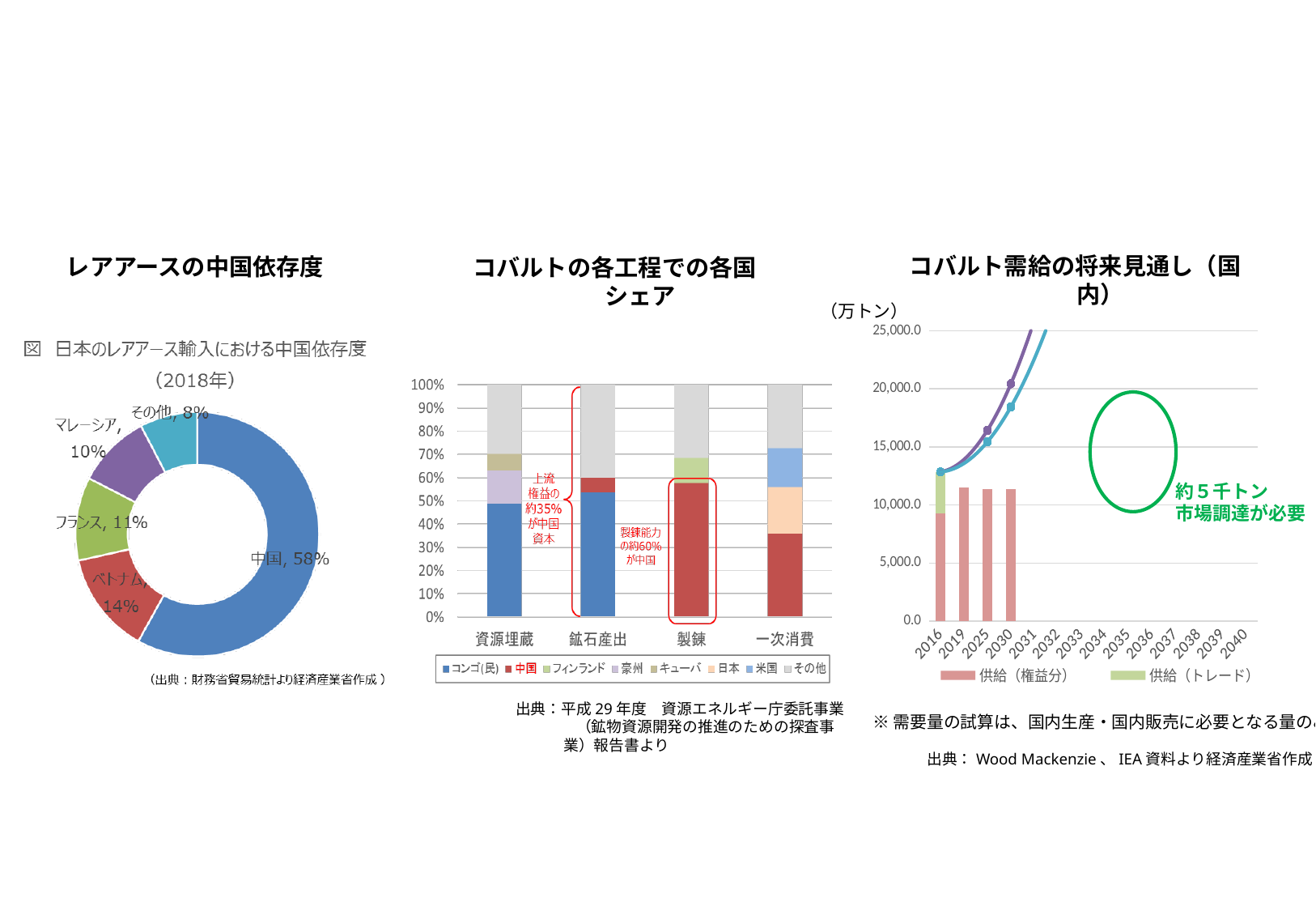
In the donut chart titled レアアースの中国依存度, what share is shown for ベトナム? 14% What kind of chart is the one titled コバルトの各工程での各国シェア? Stacked bar chart How many slices does the donut chart titled レアアースの中国依存度 have? 5 In the donut chart titled レアアースの中国依存度, which has the larger share, フランス or マレーシア? フランス In the donut chart titled レアアースの中国依存度, which slice is the smallest? その他 How many series does the legend of the chart titled コバルト需給の将来見通し（国内） list? 2 In the donut chart titled レアアースの中国依存度, what is the difference between the shares of 中国 and ベトナム? 44% In the donut chart titled レアアースの中国依存度, which country has the largest share? 中国 In the chart titled コバルト需給の将来見通し（国内）, is the 供給（権益分） bar for 2019 greater or less than 10,000.0? greater In the donut chart titled レアアースの中国依存度, what share is shown for 中国? 58% In the chart titled コバルトの各工程での各国シェア, is the share of 中国 in 製錬 greater or less than 50%? greater How many series does the legend of the chart titled コバルトの各工程での各国シェア list? 8